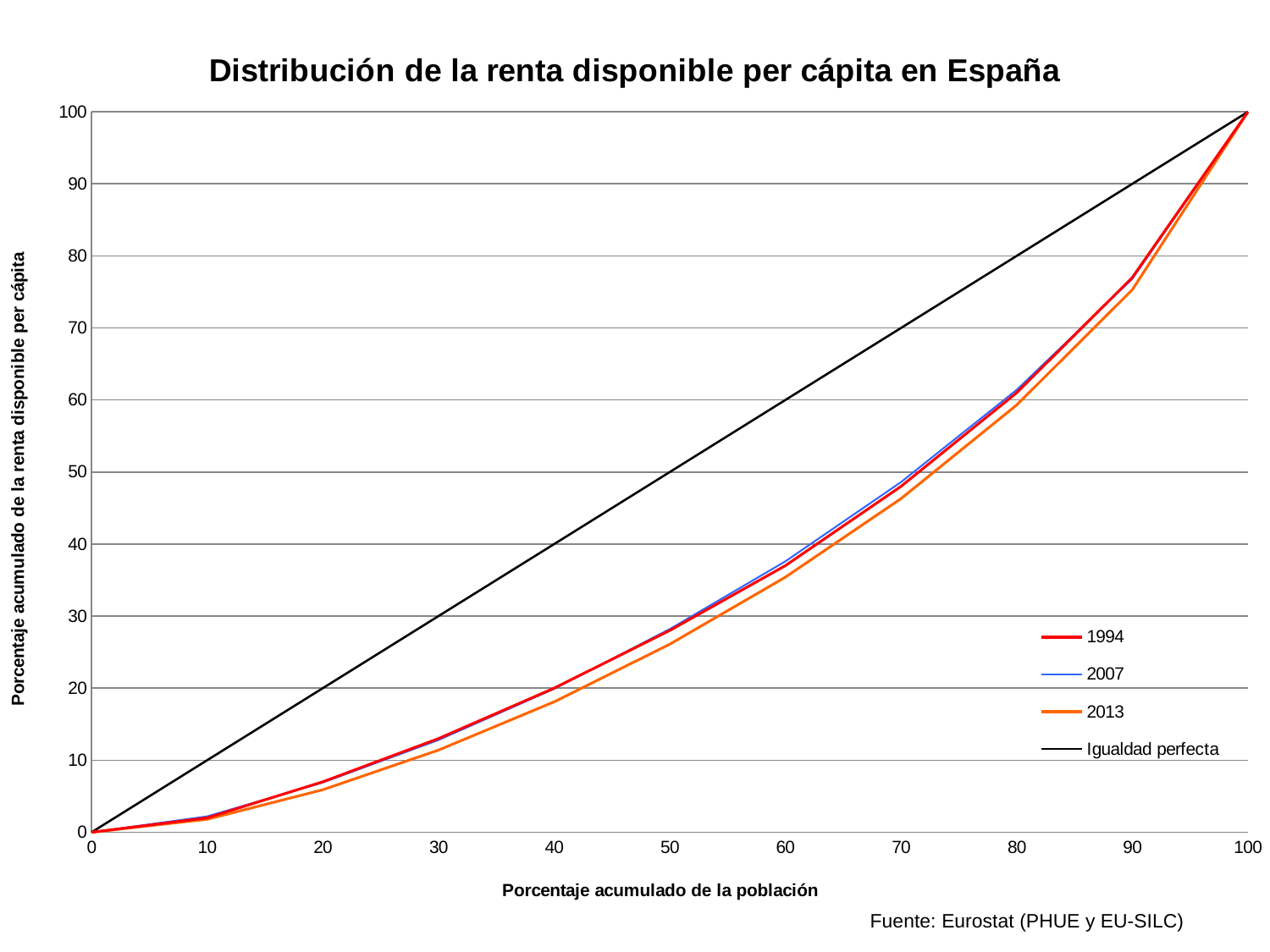
Is the value for 1994 at 20 on the x axis greater or less than 10? less What kind of chart is shown on the slide? Line chart Is the value for 2013 at 60 on the x axis greater or less than 40? less How many series does the legend list? 4 What is the value of the Igualdad perfecta line at 50 on the x axis? 50 At 90 on the x axis, which is higher: the 1994 line or the 2013 line? 1994 What value do all the series reach at 100 on the x axis? 100 Which series is drawn as a straight diagonal line from 0 to 100? Igualdad perfecta Do the values of the 2013 series rise or fall as the x axis increases? Rise Is the value for 1994 at 90 on the x axis greater or less than 80? less What is the title of the chart? Distribución de la renta disponible per cápita en España